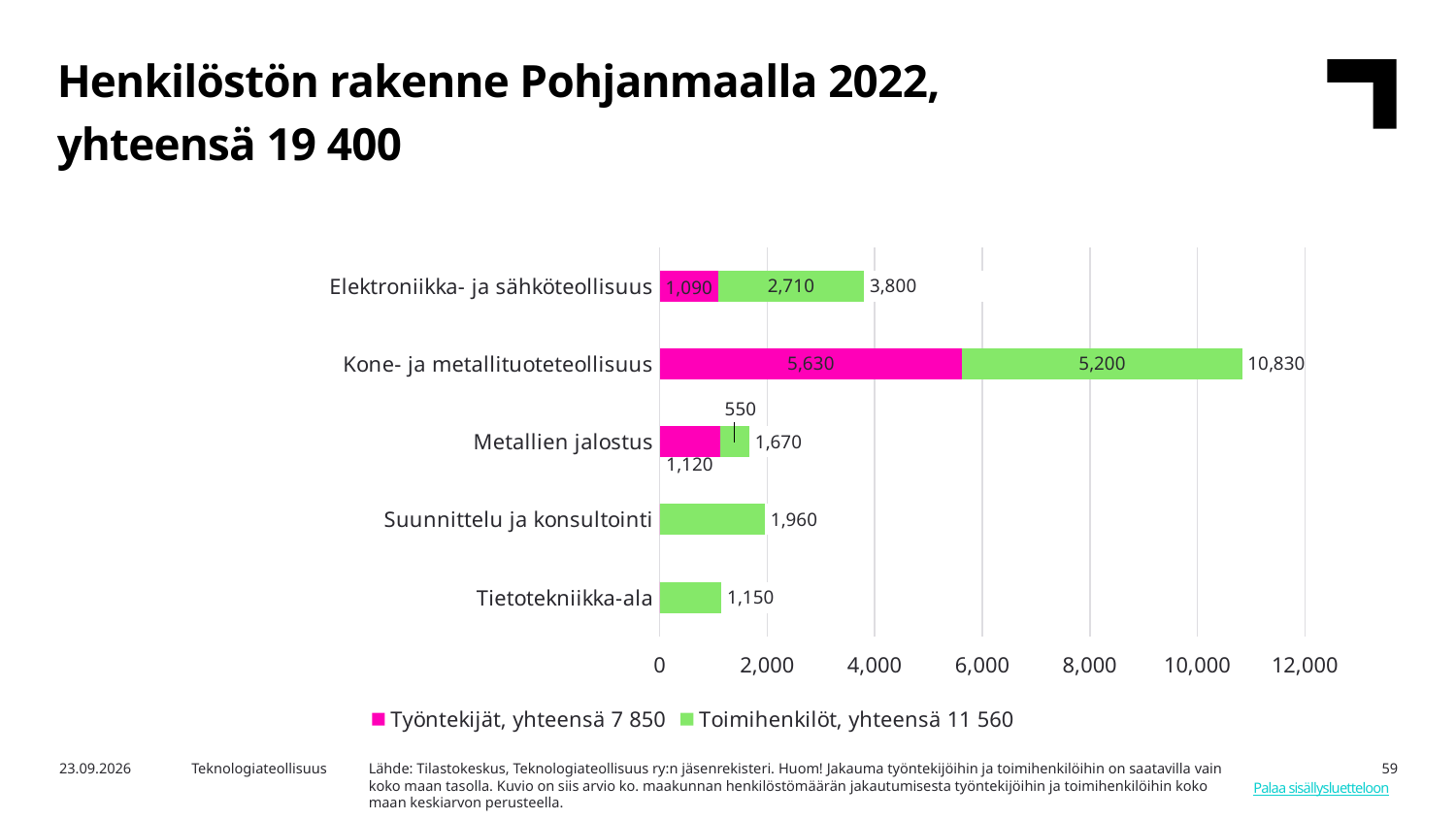
What is the difference between the Työntekijät and Toimihenkilöt values for Kone- ja metallituoteteollisuus? 430 How many series does the legend list? 2 What is the total value shown for Metallien jalostus? 1,670 Which category has the lowest total? Tietotekniikka-ala Which category has the highest total? Kone- ja metallituoteteollisuus What type of chart is shown on the slide? Stacked bar chart What is the Toimihenkilöt value for Elektroniikka- ja sähköteollisuus? 2,710 Is the total for Kone- ja metallituoteteollisuus greater or less than 10,000? greater How many categories are shown on the chart? 5 Which is larger: the total for Suunnittelu ja konsultointi or the total for Tietotekniikka-ala? Suunnittelu ja konsultointi What total for Työntekijät is given in the legend? 7 850 What is the Työntekijät value for Kone- ja metallituoteteollisuus? 5,630